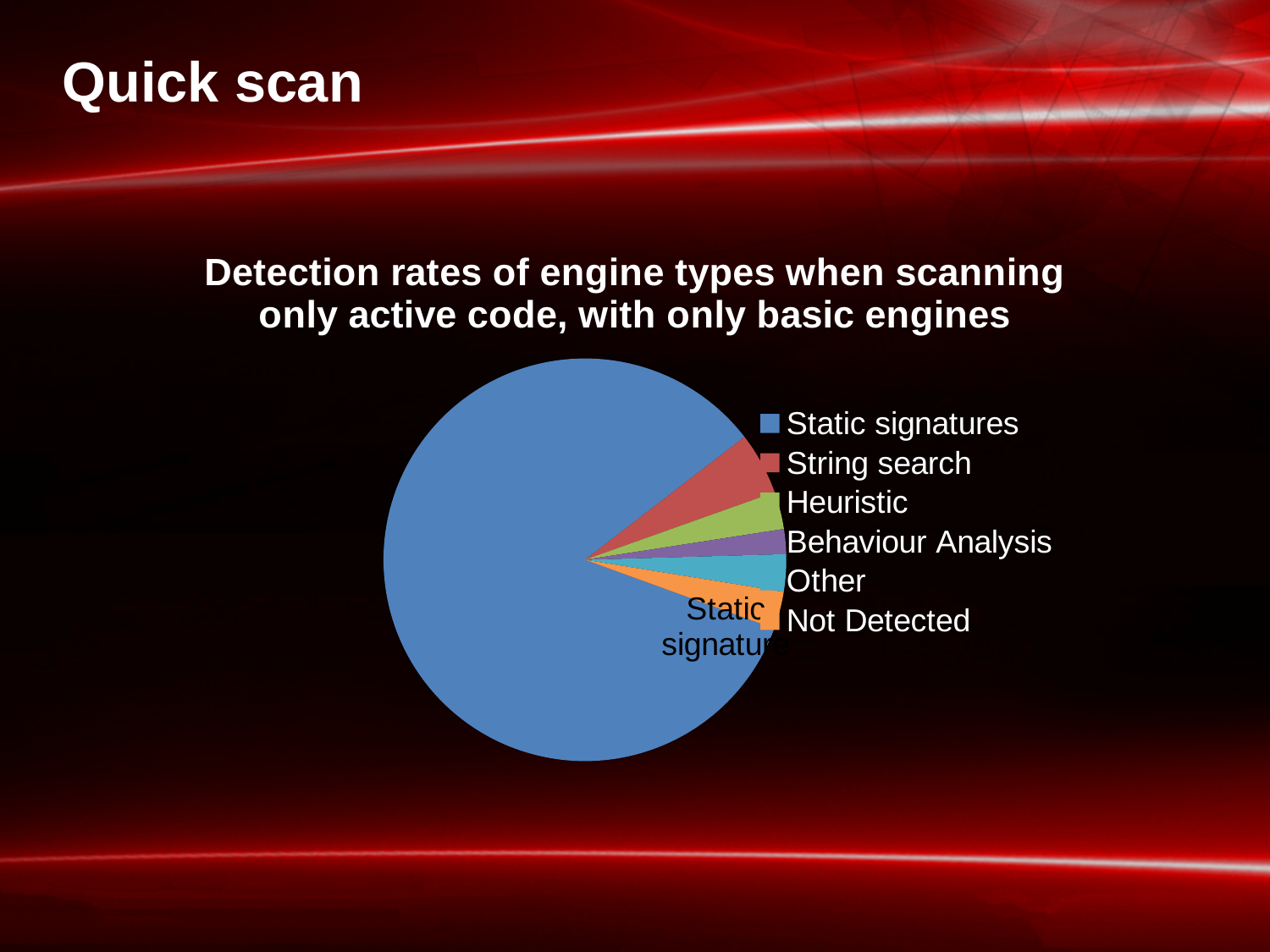
What is the title of the chart? Detection rates of engine types when scanning only active code, with only basic engines Which slice is larger, Static signatures or Not Detected? Static signatures Which legend entry is listed last in the pie chart's legend? Not Detected How many categories does the legend of the pie chart list? 6 What kind of chart is shown on the slide? pie chart Which slice is larger, Static signatures or String search? Static signatures How many slices does the pie chart have? 6 Which slice is larger, String search or Heuristic? String search What colour is the Static signatures slice in the pie chart? blue Which category has the largest slice of the pie chart? Static signatures